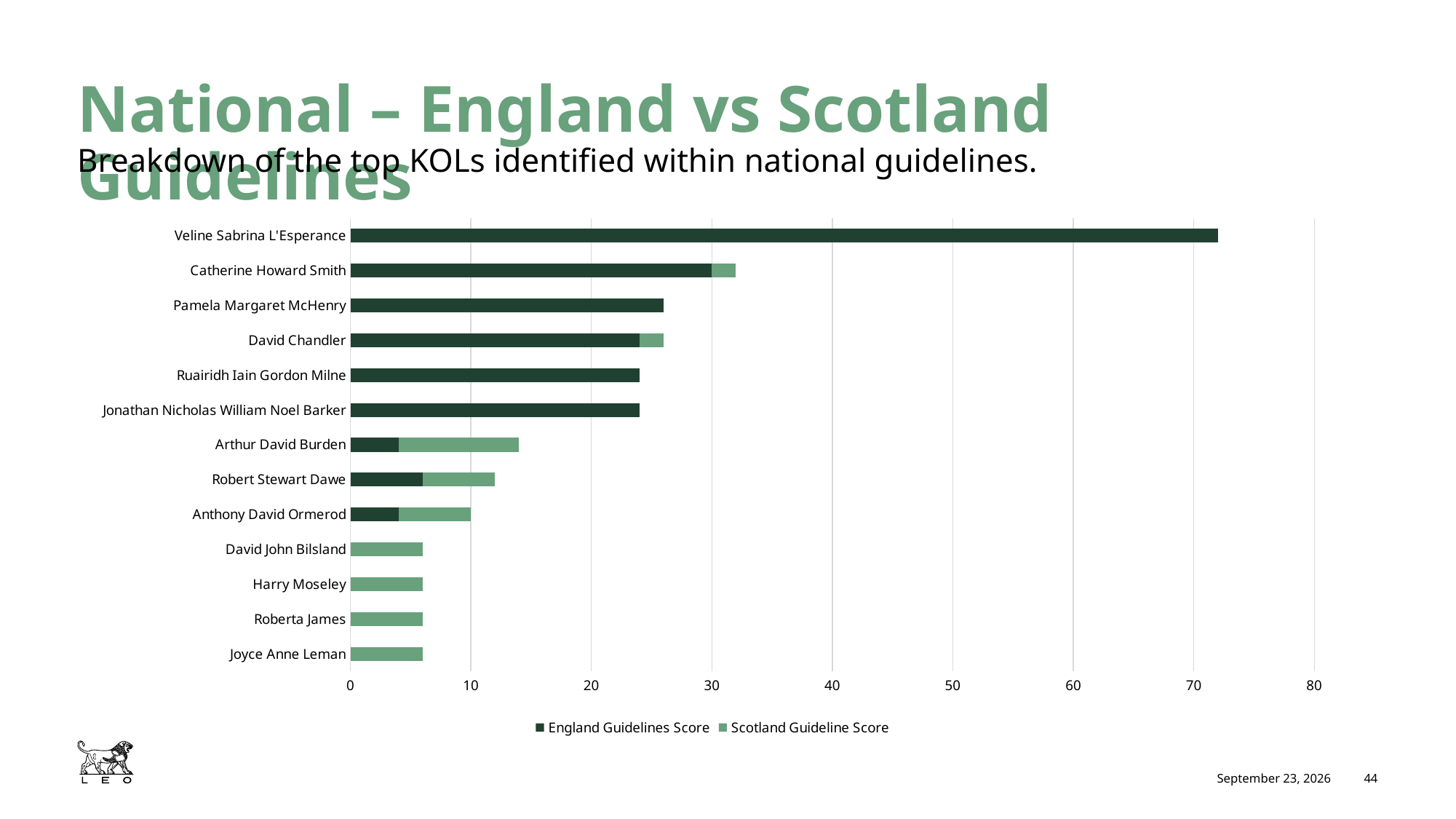
What kind of chart is shown on the slide? Bar chart Is the total bar for Veline Sabrina L'Esperance greater or less than 70? greater Is the total bar for Harry Moseley greater or less than 10? less How many series does the legend list? 2 How many KOLs (categories) are plotted on the chart? 13 What are the two series named in the legend? England Guidelines Score and Scotland Guideline Score Which has the larger total bar, Pamela Margaret McHenry or Robert Stewart Dawe? Pamela Margaret McHenry Which has the larger total bar, Catherine Howard Smith or David Chandler? Catherine Howard Smith Which series is shown in the darker green colour? England Guidelines Score Which KOL has the highest total score on the chart? Veline Sabrina L'Esperance Is the total bar for Catherine Howard Smith greater or less than 40? less